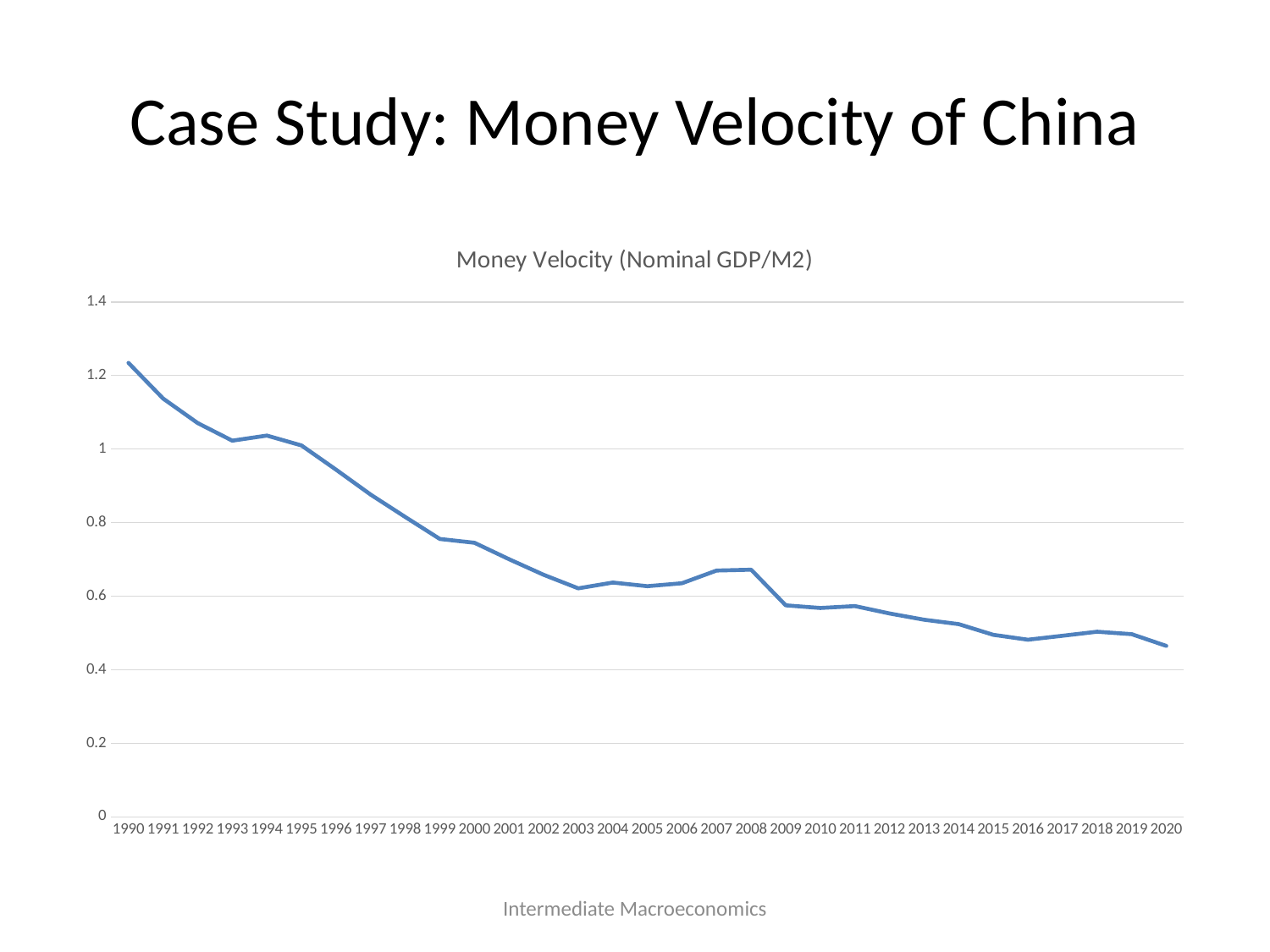
Which year has the lowest money velocity in the chart? 2020 What kind of chart is shown on the slide? line chart How many years are plotted along the x axis of the chart? 31 Is the money velocity for 1999 greater or less than 0.8? less Overall, does money velocity rise or fall from 1990 to 2020? fall Which year has the highest money velocity in the chart? 1990 Is the money velocity for 1990 greater or less than 1? greater Is the money velocity for 1996 greater or less than 1? less What is the title of the chart? Money Velocity (Nominal GDP/M2) Which year has the higher money velocity, 2008 or 2009? 2008